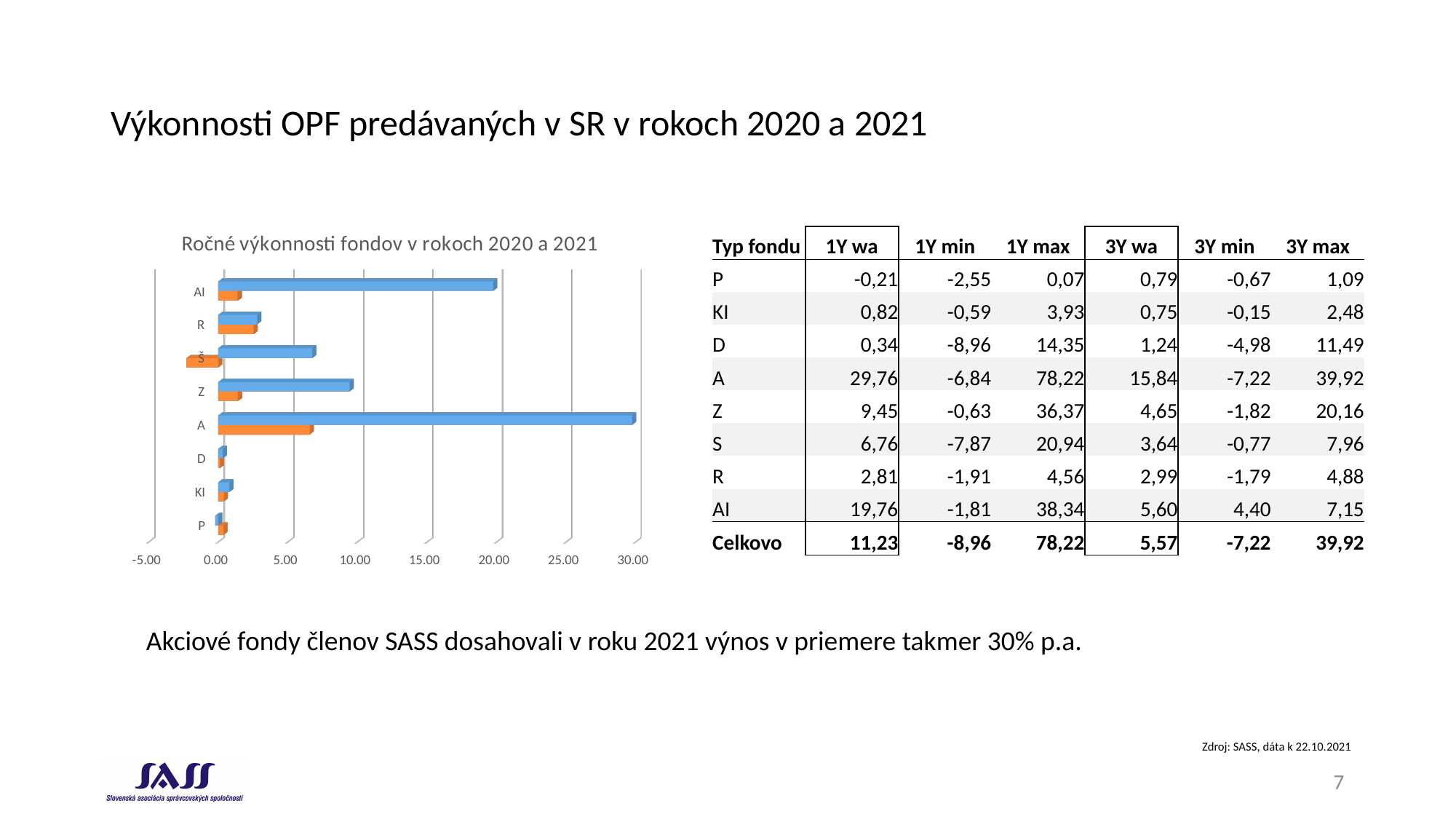
Is the blue bar for AI greater or less than 15.00? greater What kind of chart is shown on the slide? bar chart What is the highest value shown on the chart's horizontal axis? 30.00 Is the blue bar for A greater or less than 25.00? greater Is the blue bar for Z greater or less than 10.00? less Which has the longer blue bar, AI or Z? AI Which category has the lowest (negative) orange bar in the chart? Š Which category has the longest blue bar in the chart? A Which has the longer blue bar, R or Š? Š What is the title of the chart on the slide? Ročné výkonnosti fondov v rokoch 2020 a 2021 How many fund categories are shown on the chart's vertical axis? 8